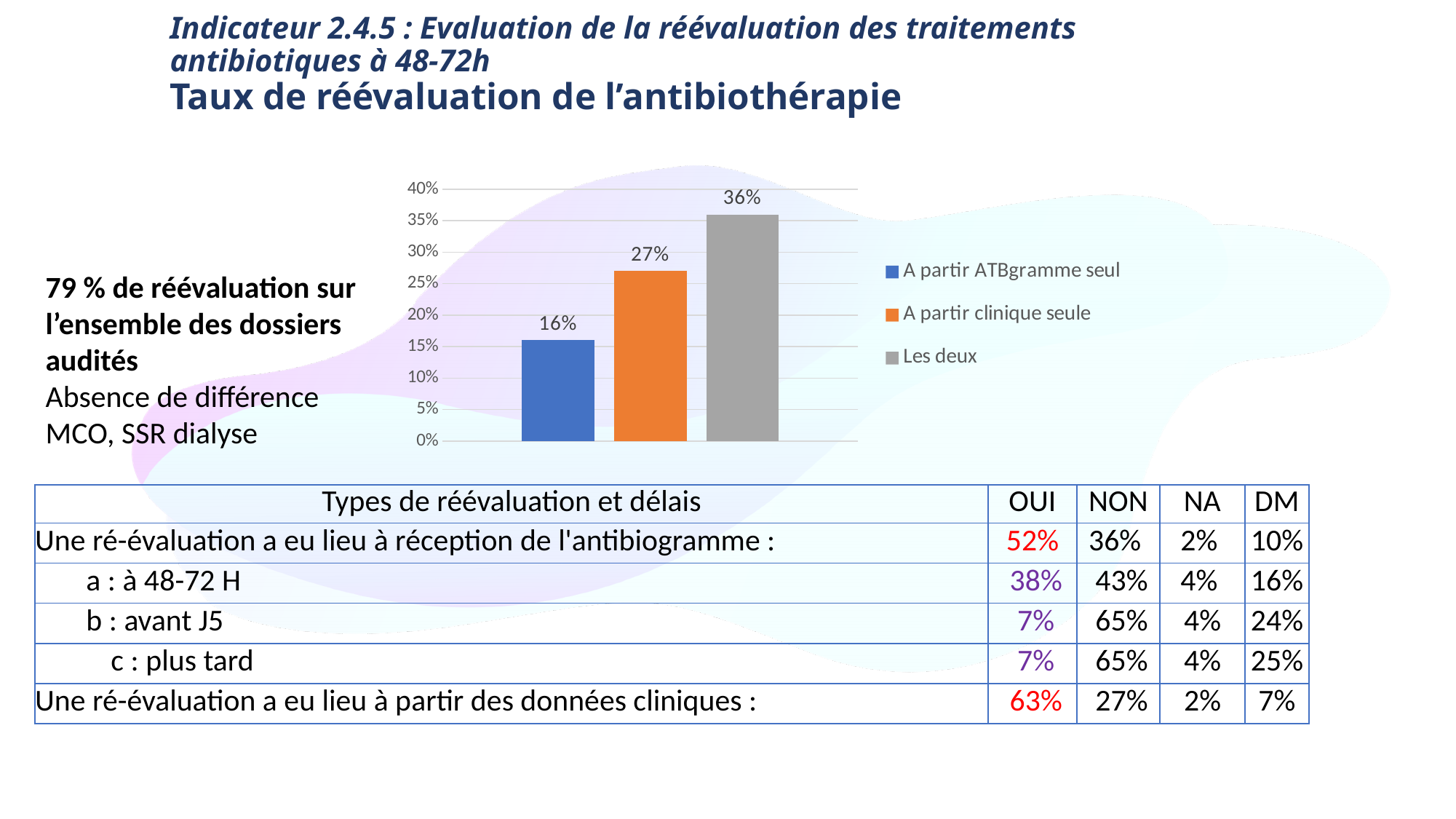
What colour is the bar for 'A partir clinique seule'? orange What is the difference between the values for 'Les deux' and 'A partir ATBgramme seul'? 20% What is the value for 'Les deux' in the chart? 36% Is the value for 'Les deux' greater or less than 30%? greater What kind of chart is shown on the slide? bar chart Which is larger: the value for 'A partir clinique seule' or the value for 'A partir ATBgramme seul'? A partir clinique seule What is the value for 'A partir ATBgramme seul' in the chart? 16% How many series does the legend list? 3 What is the value for 'A partir clinique seule' in the chart? 27% Which series has the highest value in the chart? Les deux Which series has the lowest value in the chart? A partir ATBgramme seul What is the difference between the values for 'A partir clinique seule' and 'A partir ATBgramme seul'? 11%